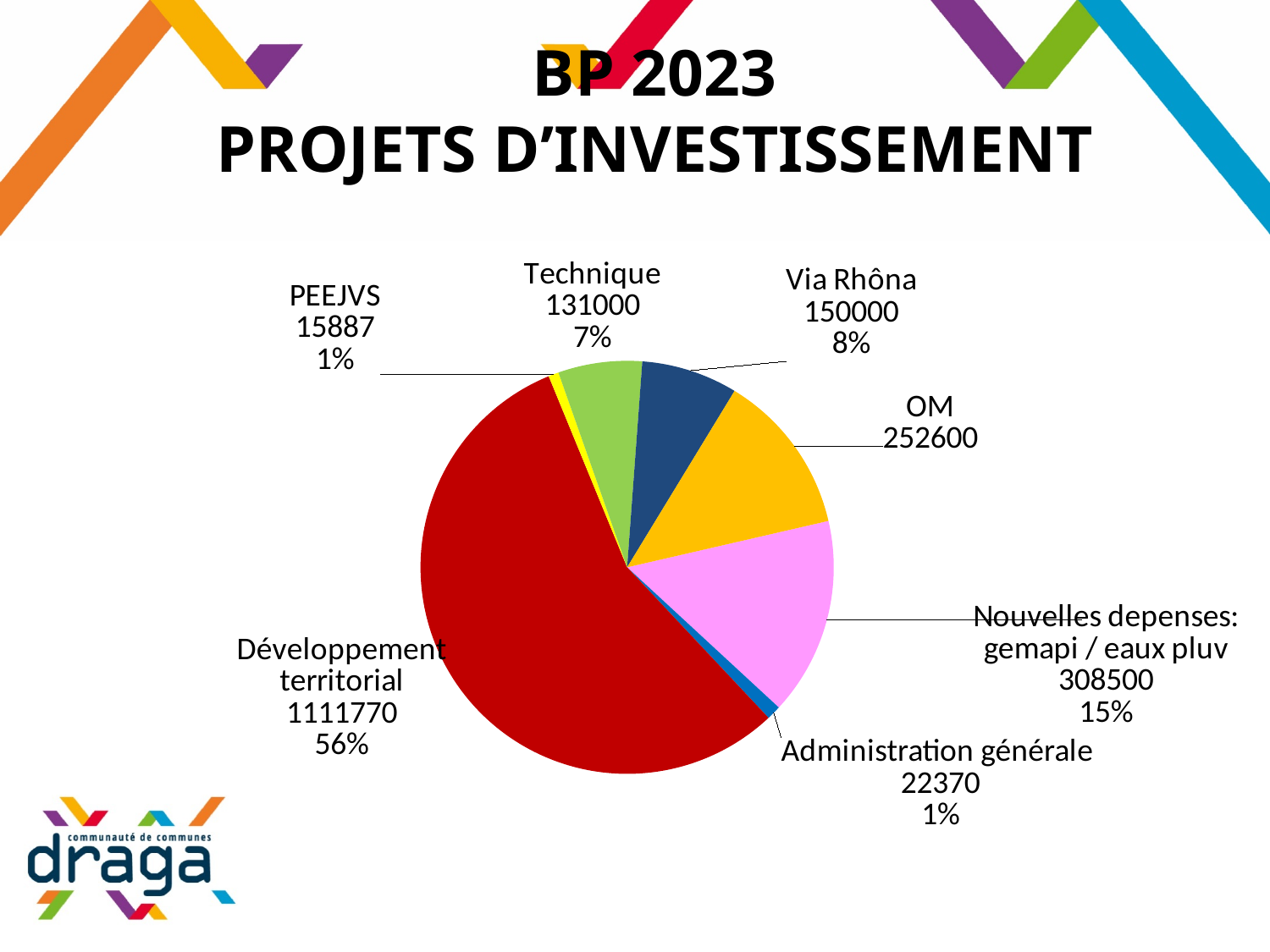
What is the value for Via Rhôna? 150000 Which category has the smallest value? PEEJVS What type of chart is shown on the slide? pie chart What share of the pie does Technique represent? 7% What is the value for Administration générale? 22370 What is the value for Développement territorial? 1111770 How many slices does the pie chart have? 7 Which is larger, the value for OM or the value for Nouvelles depenses: gemapi / eaux pluv? Nouvelles depenses: gemapi / eaux pluv What is the value for OM? 252600 What share of the pie does Nouvelles depenses: gemapi / eaux pluv represent? 15% Which category has the largest slice of the pie? Développement territorial What is the difference between the values for Via Rhôna and Technique? 19000